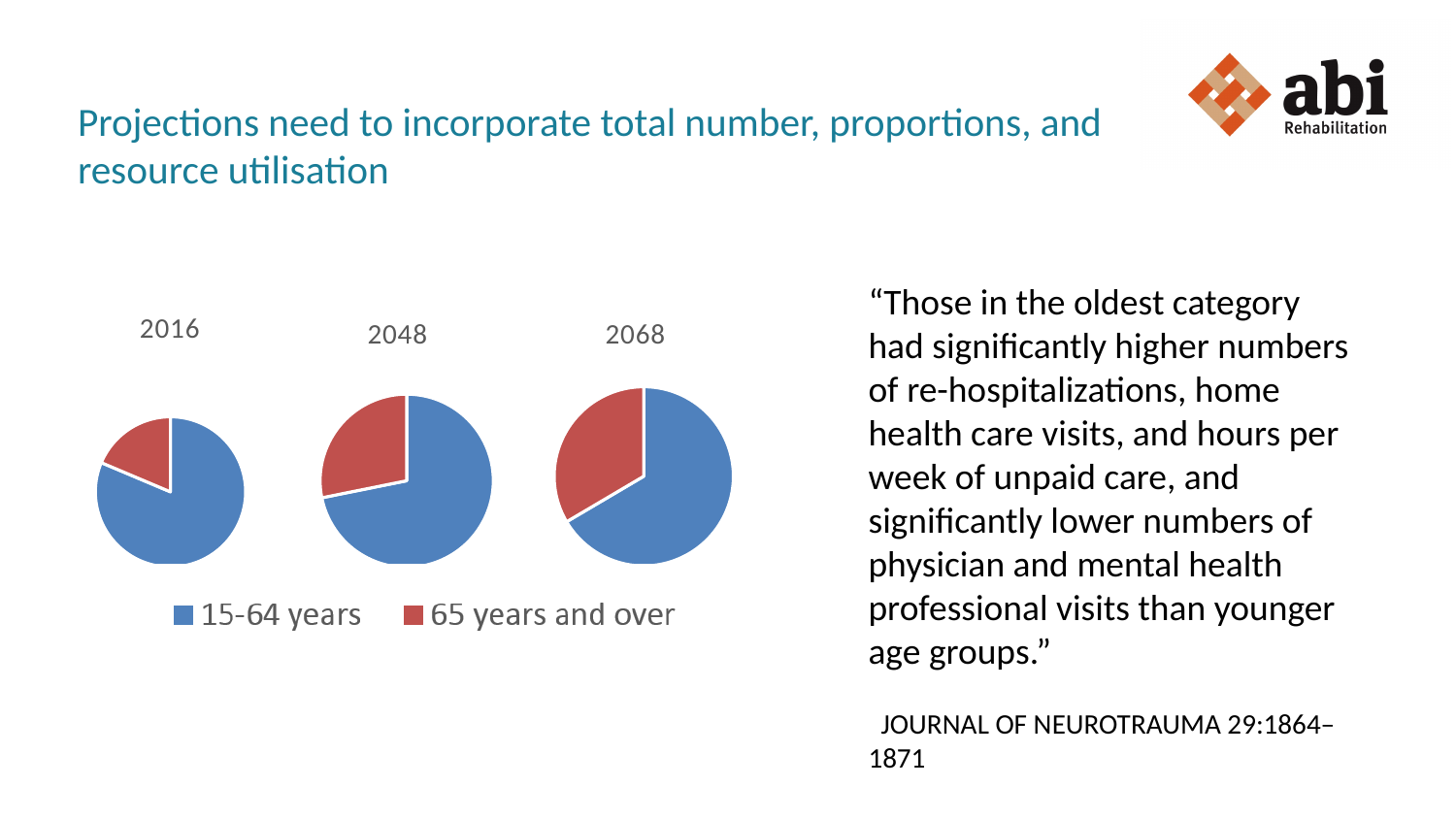
What kind of chart is used for the 2016 chart? pie chart What are the titles of the three pie charts, from left to right? 2016, 2048, 2068 In the 2068 pie chart, which is larger: the 15-64 years slice or the 65 years and over slice? 15-64 years How many categories does the legend list for the pie charts? 2 Which of the three pie charts has the largest 65 years and over slice? 2068 Which of the three pie charts has the smallest 65 years and over slice? 2016 In the 2016 pie chart, which is larger: the 15-64 years slice or the 65 years and over slice? 15-64 years What colour represents the 65 years and over category in the pie charts? red Across the 2016, 2048 and 2068 pie charts, does the share of the 65 years and over slice rise or fall over time? rise Across the 2016, 2048 and 2068 pie charts, does the share of the 15-64 years slice rise or fall over time? fall How many pie charts are shown on the slide? 3 In the 2048 pie chart, which is larger: the 15-64 years slice or the 65 years and over slice? 15-64 years